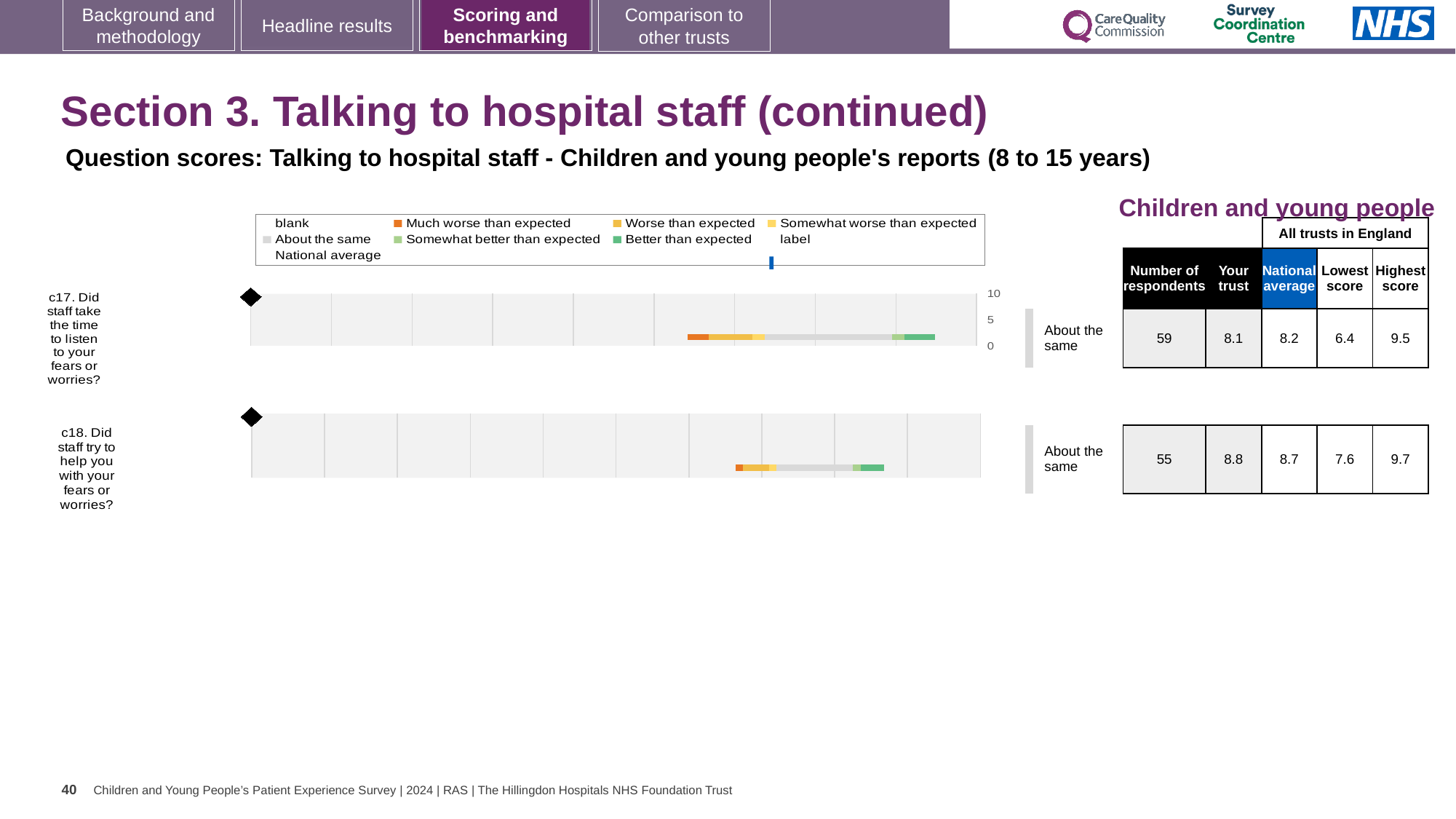
What benchmark category label is shown next to the c18 bar? About the same What is the highest score across all trusts in England for c17? 9.5 What is the lowest score across all trusts in England for c18? 7.6 By how much does the national average exceed the trust's score for c17? 0.1 What is the national average score for c18 (Did staff try to help you with your fears or worries?)? 8.7 What kind of chart is used to show the question scores for c17 and c18? Bar chart How many survey questions are plotted on the slide? 2 Which question has more respondents, c17 or c18? c17 Which question has the higher 'Your trust' score, c17 or c18? c18 What is the 'Your trust' score for c17 (Did staff take the time to listen to your fears or worries?)? 8.1 How many respondents answered c17? 59 What is the difference between the highest and lowest scores for c18? 2.1